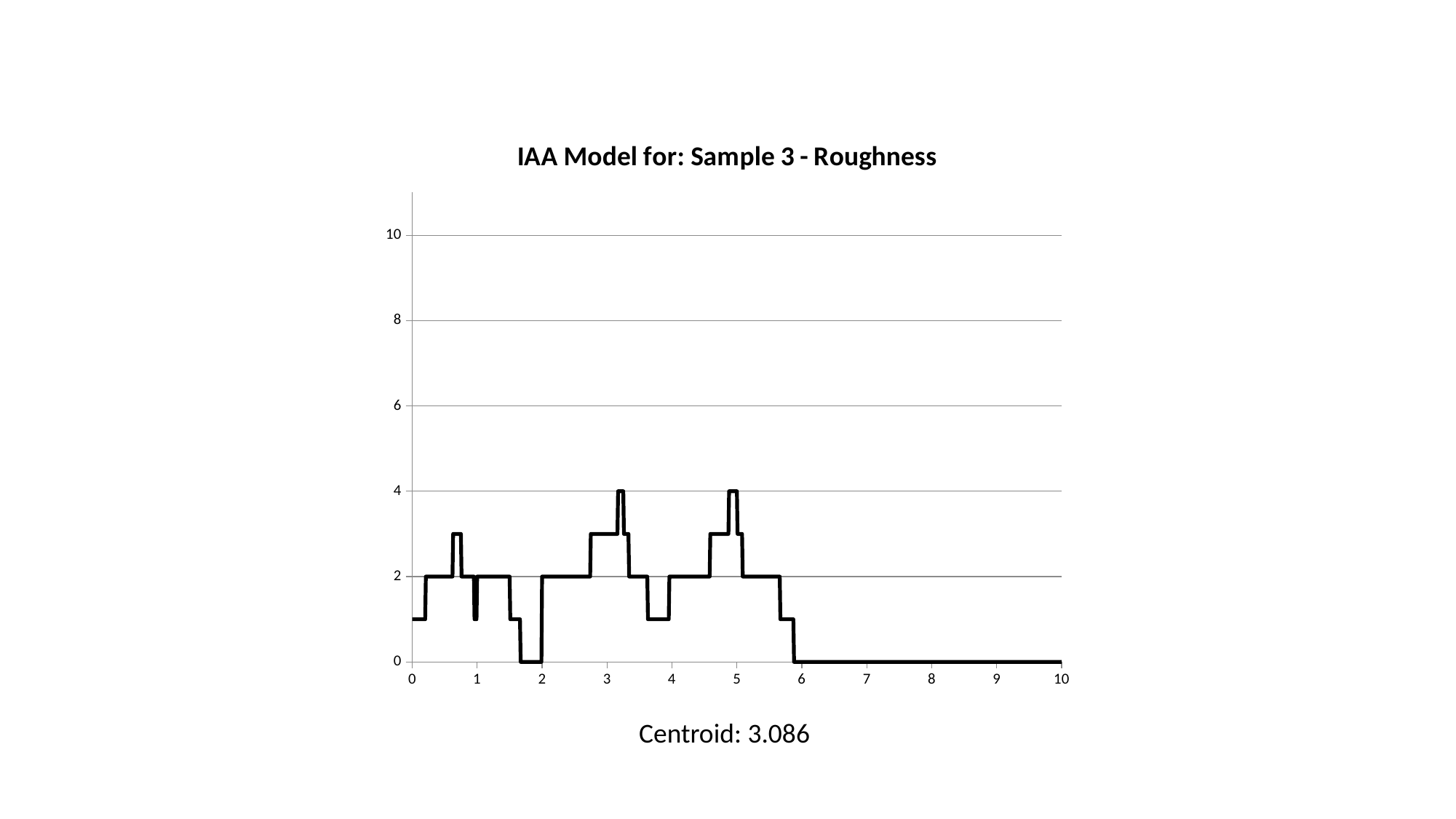
Is the value of the line at x = 1.8 greater or less than 2? less Is the value of the line at x = 7 greater or less than 2? less What is the highest tick label shown on the y axis? 10 What is the title of the chart? IAA Model for: Sample 3 - Roughness What is the value of the line at x = 8? 0 What centroid value is printed below the chart? 3.086 What is the highest value the line reaches on the y axis? 4 What is the value of the line at x = 2.5? 2 Is the value of the line at x = 3 greater or less than 2? greater What is the value of the line at x = 9? 0 Does the line rise or fall between x = 5.5 and x = 6? fall What kind of chart is shown on the slide? line chart